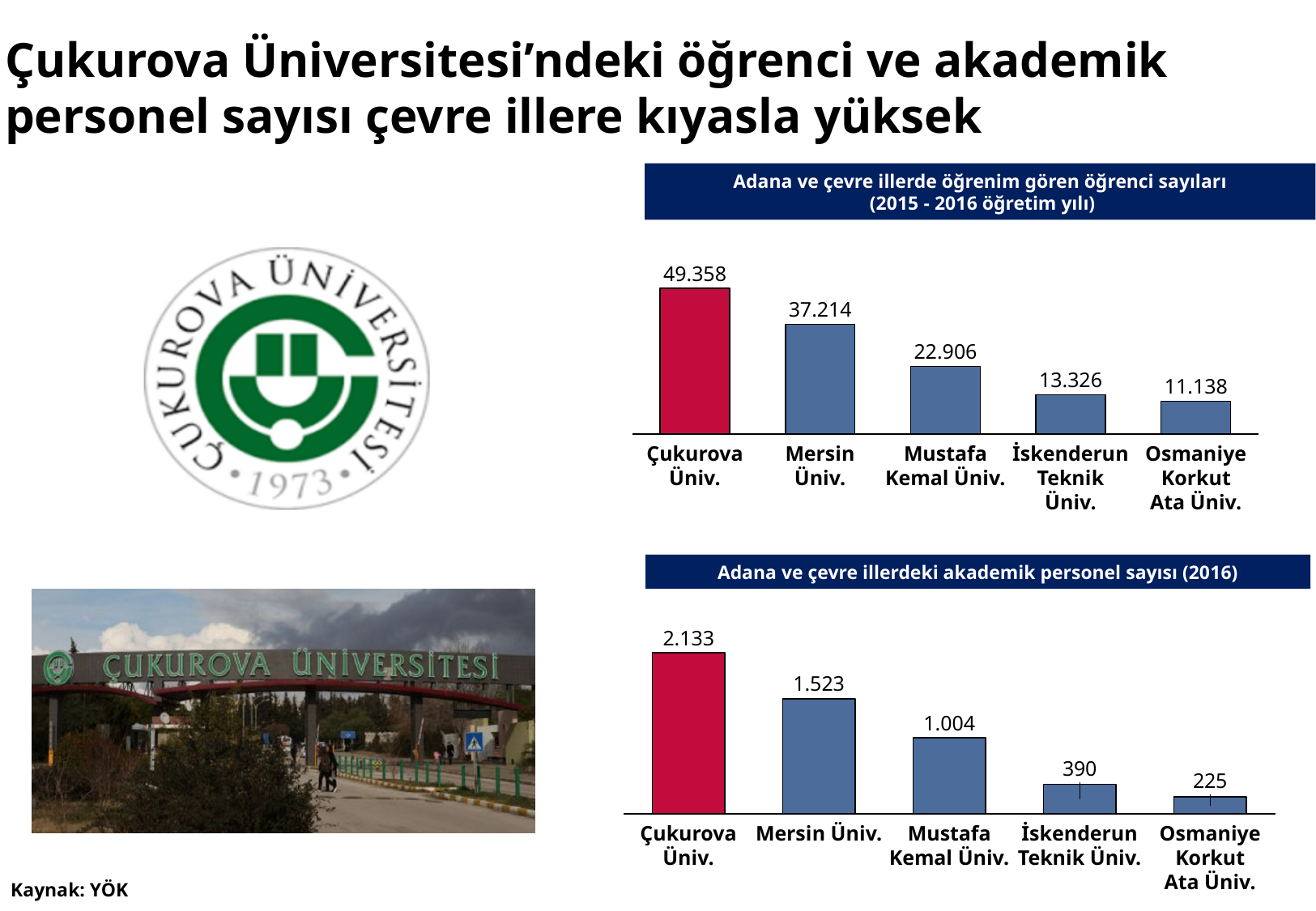
In the bottom chart (akademik personel sayısı), which is larger, İskenderun Teknik Üniv. or Osmaniye Korkut Ata Üniv.? İskenderun Teknik Üniv. In the top chart (öğrenci sayıları), which bar is coloured red? Çukurova Üniv. In the bottom chart (akademik personel sayısı), what is the value for Mustafa Kemal Üniv.? 1.004 In the top chart (öğrenci sayıları), which university has the lowest value? Osmaniye Korkut Ata Üniv. In the top chart (öğrenci sayıları), how many universities are shown? 5 In the bottom chart (akademik personel sayısı), what is the value for Osmaniye Korkut Ata Üniv.? 225 In the top chart (öğrenci sayıları), which university has the highest number of students? Çukurova Üniv. In the top chart (öğrenci sayıları), what is the difference between Çukurova Üniv. and Mersin Üniv.? 12.144 What type of chart is the bottom chart (akademik personel sayısı)? Bar chart In the top chart (Adana ve çevre illerde öğrenim gören öğrenci sayıları), what is the value for Mersin Üniv.? 37.214 In the bottom chart (akademik personel sayısı), do the values rise or fall from left to right? Fall In the bottom chart (akademik personel sayısı), what is the difference between Çukurova Üniv. and Mersin Üniv.? 610